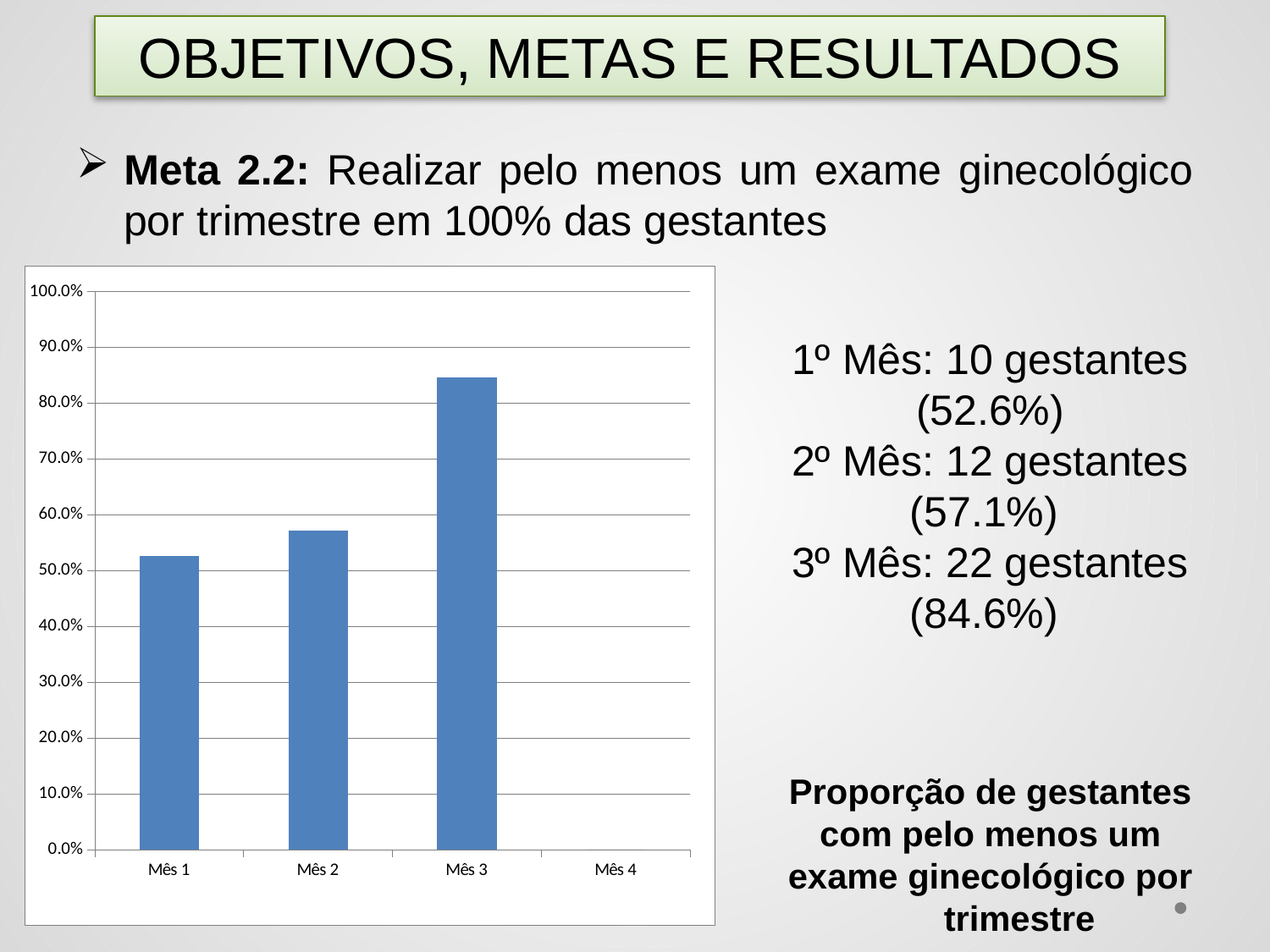
Which month has the highest bar in the chart? Mês 3 What is the highest value shown on the y axis of the chart? 100.0% Which is larger, the value for Mês 2 or the value for Mês 3? Mês 3 Which of the months with a visible bar has the lowest value? Mês 1 According to the text beside the chart, what proportion of pregnant women had at least one gynecological exam in the 3º Mês? 84.6% According to the text beside the chart, what proportion is given for the 1º Mês? 52.6% Is the value for Mês 1 greater or less than 60.0%? less Do the bar values rise or fall from Mês 1 to Mês 3? rise Is the value for Mês 2 greater or less than 50.0%? greater Is the value for Mês 3 greater or less than 80.0%? greater What kind of chart is shown on the slide? bar chart How many categories are shown on the x axis of the chart? 4